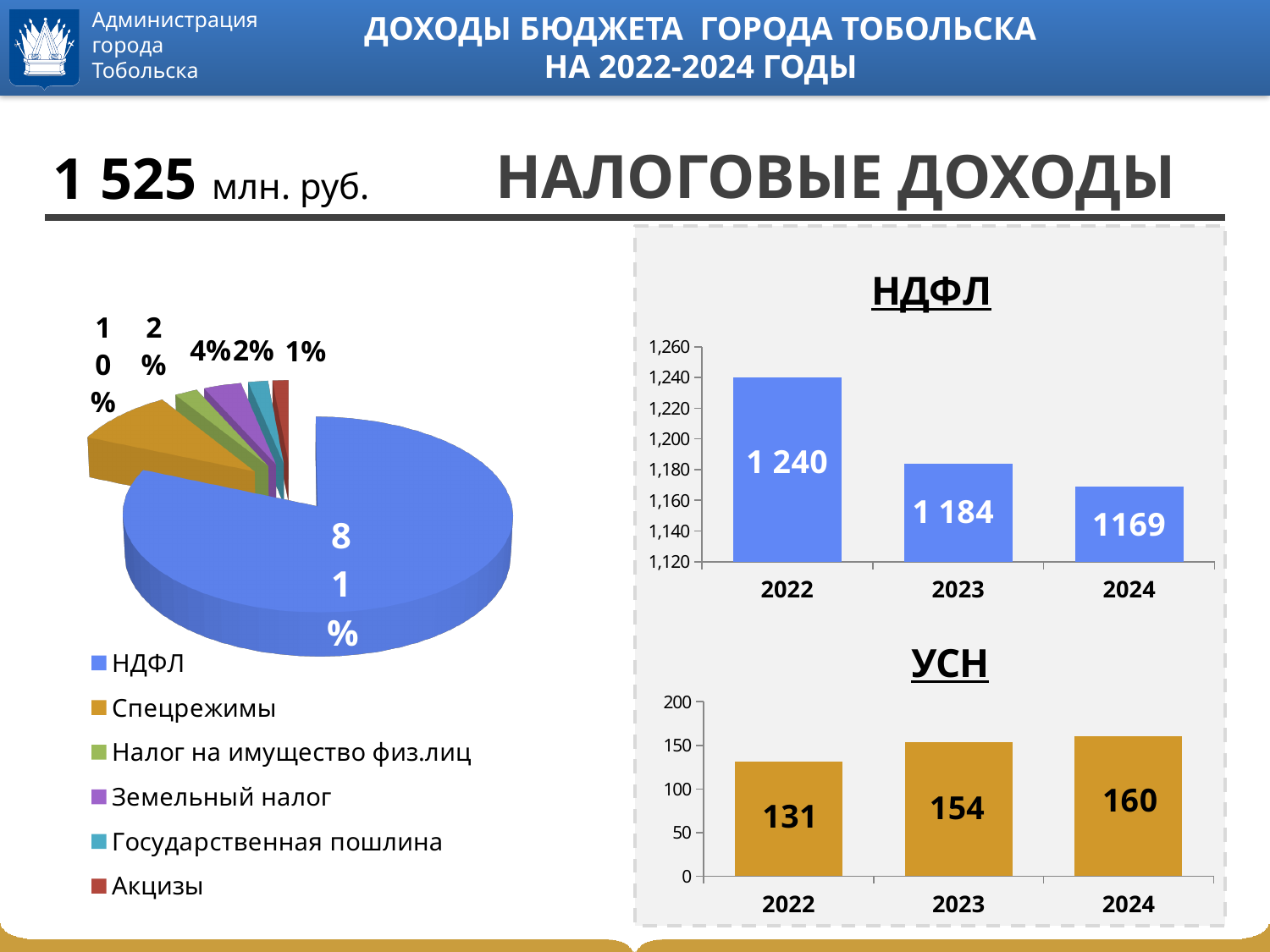
On the НДФЛ chart, what is the value for 2024? 1169 On the УСН chart, which year has the highest value? 2024 On the НДФЛ chart, what is the difference between the 2022 and 2023 values? 56 On the УСН chart, is the value for 2022 greater or less than 150? less On the УСН chart, do the values rise or fall from 2022 to 2024? rise On the НДФЛ chart, what is the value for 2022? 1 240 How many entries does the legend of the pie chart on the left list? 6 On the УСН chart, what is the difference between the 2024 and 2022 values? 29 On the pie chart on the left, what share does НДФЛ have? 81% On the НДФЛ chart, do the values rise or fall from 2022 to 2024? fall On the УСН chart, what is the value for 2023? 154 On the pie chart on the left, what share does Спецрежимы have? 10%